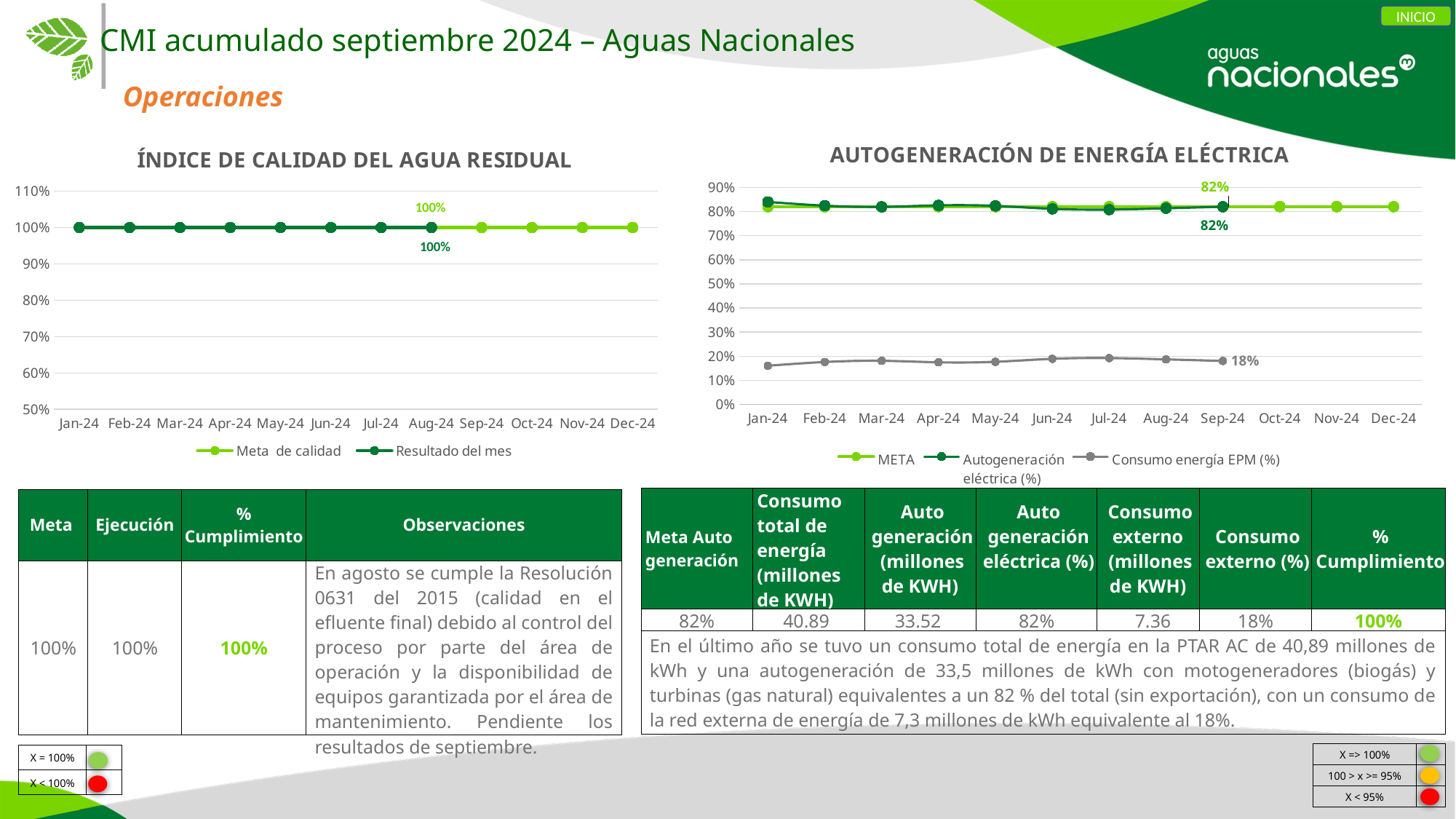
In the 'ÍNDICE DE CALIDAD DEL AGUA RESIDUAL' chart, what value is labelled for 'Resultado del mes'? 100% What kind of chart is the 'ÍNDICE DE CALIDAD DEL AGUA RESIDUAL' chart? Line chart In the 'AUTOGENERACIÓN DE ENERGÍA ELÉCTRICA' chart, what is the labelled value of 'Autogeneración eléctrica (%)' at Sep-24? 82% In the 'AUTOGENERACIÓN DE ENERGÍA ELÉCTRICA' chart, which series is higher at Sep-24: 'Autogeneración eléctrica (%)' or 'Consumo energía EPM (%)'? Autogeneración eléctrica (%) In the 'ÍNDICE DE CALIDAD DEL AGUA RESIDUAL' chart, what value is labelled for 'Meta de calidad'? 100% In the 'AUTOGENERACIÓN DE ENERGÍA ELÉCTRICA' chart, is the value of 'Consumo energía EPM (%)' at Jan-24 greater or less than 20%? less In the 'AUTOGENERACIÓN DE ENERGÍA ELÉCTRICA' chart, what is the labelled value of 'Consumo energía EPM (%)' at Sep-24? 18% How many series does the legend of the 'ÍNDICE DE CALIDAD DEL AGUA RESIDUAL' chart list? 2 How many series does the legend of the 'AUTOGENERACIÓN DE ENERGÍA ELÉCTRICA' chart list? 3 In the 'AUTOGENERACIÓN DE ENERGÍA ELÉCTRICA' chart, how many data points does the 'Consumo energía EPM (%)' series have? 9 How many months are shown on the x axis of the 'ÍNDICE DE CALIDAD DEL AGUA RESIDUAL' chart? 12 In the 'AUTOGENERACIÓN DE ENERGÍA ELÉCTRICA' chart, what is the difference between the Sep-24 labelled values of 'Autogeneración eléctrica (%)' and 'Consumo energía EPM (%)'? 64 percentage points